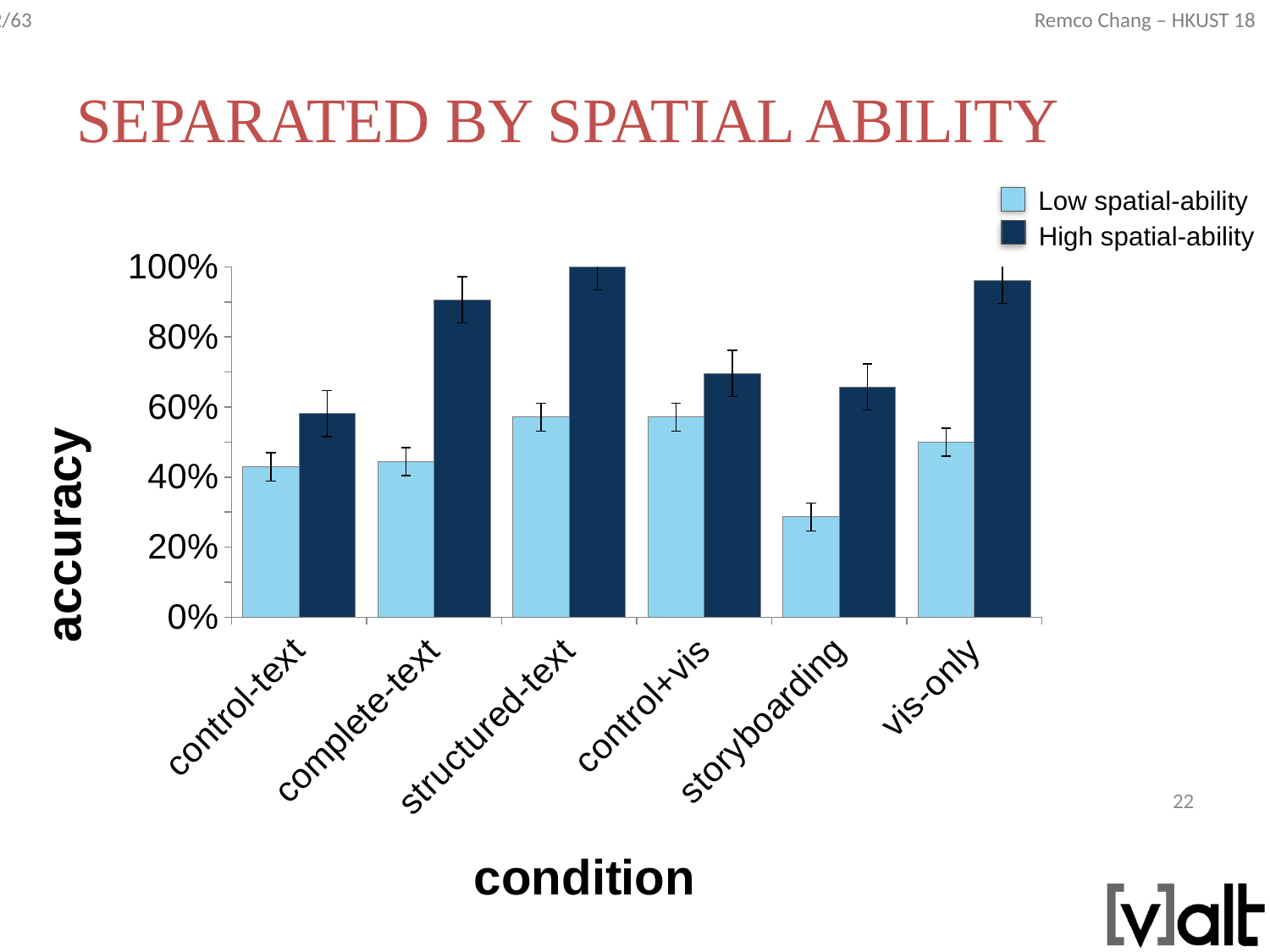
Is the Low spatial-ability accuracy for control-text greater or less than 60%? less What kind of chart is shown on the slide? bar chart How many conditions are shown along the x axis? 6 Which condition has the lowest accuracy for the High spatial-ability group? control-text Which condition has the lowest accuracy for the Low spatial-ability group? storyboarding How many series does the legend list? 2 Is the High spatial-ability accuracy for complete-text greater or less than 80%? greater Is the High spatial-ability accuracy for control+vis greater or less than 60%? greater For the storyboarding condition, which group has the higher accuracy, Low spatial-ability or High spatial-ability? High spatial-ability Which has the higher High spatial-ability accuracy, complete-text or control-text? complete-text What is the label on the y axis of the chart? accuracy